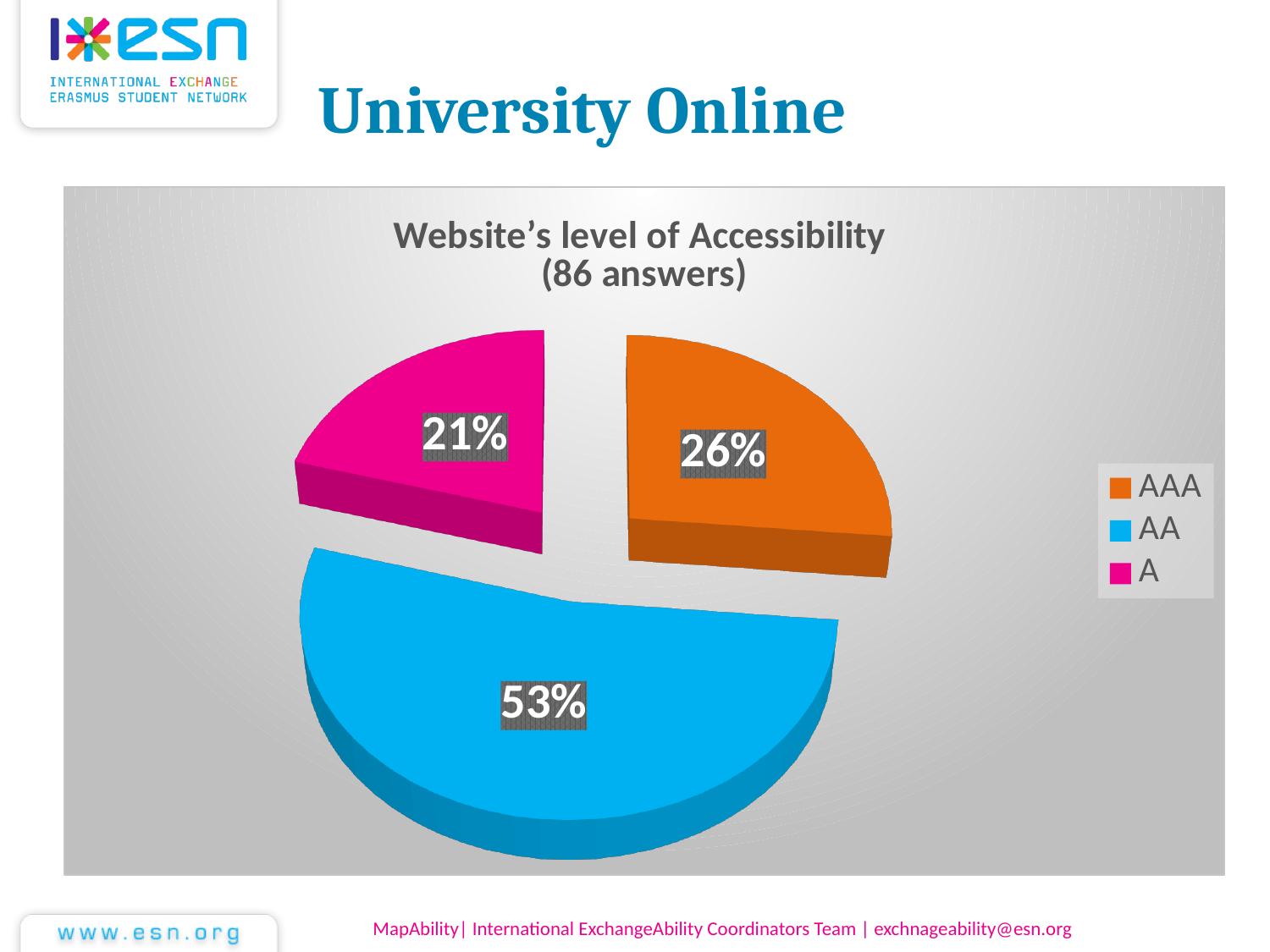
What is the difference in percentage points between the AA slice and the AAA slice? 27 What share of the pie does the AA slice represent? 53% What share of the pie does the A slice represent? 21% What is the difference in percentage points between the AAA slice and the A slice? 5 What colour is the AA slice in the pie chart? Blue How many categories are shown in the pie chart? 3 Which category has the smallest slice of the pie? A Which category has the largest slice of the pie? AA Which is larger, the AAA slice or the A slice? AAA What is the title of the chart? Website's level of Accessibility (86 answers) What kind of chart is shown on the slide? Pie chart What share of the pie does the AAA slice represent? 26%